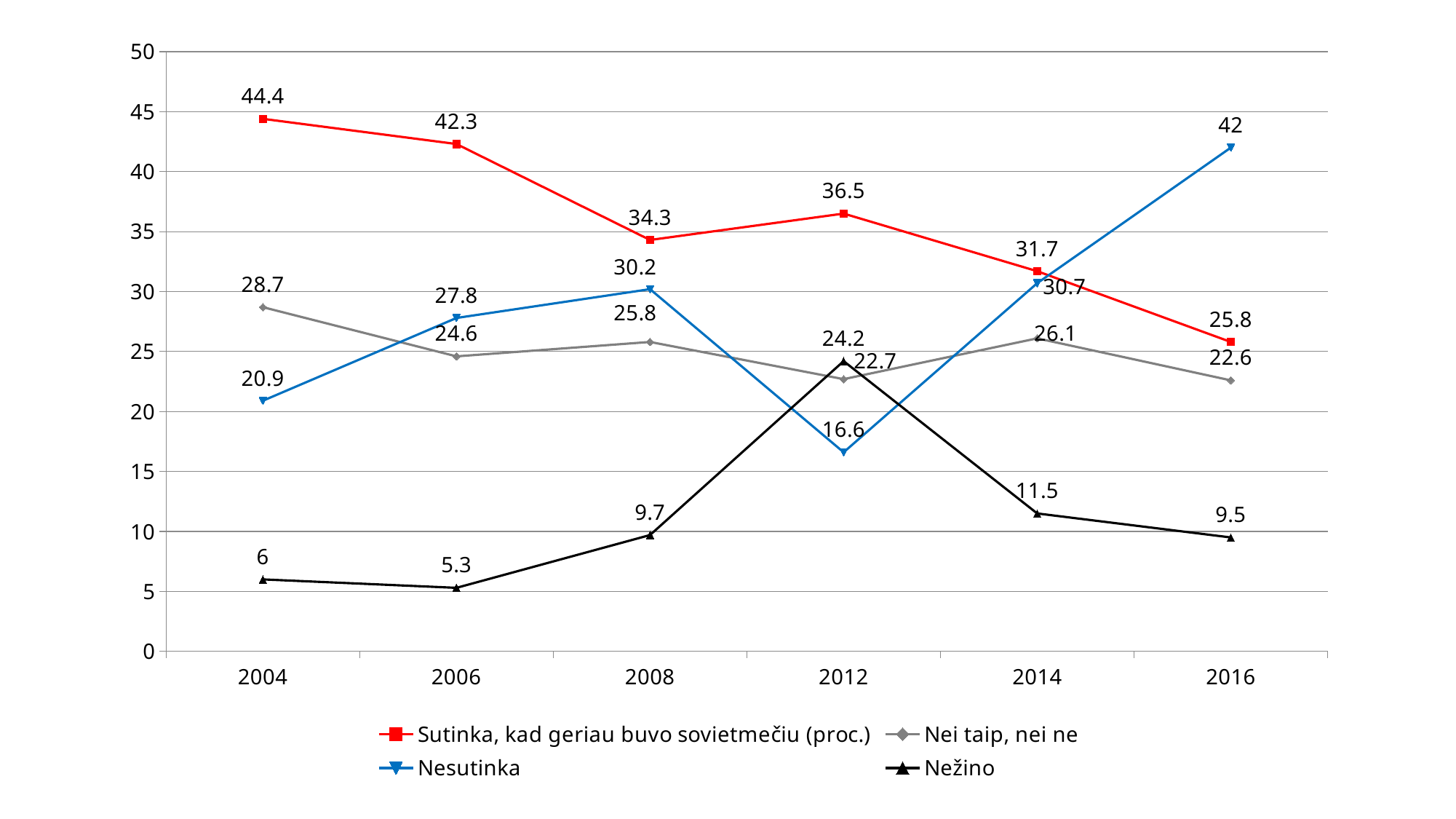
What is the value for 'Sutinka, kad geriau buvo sovietmečiu (proc.)' in 2004? 44.4 What is the value for 'Nesutinka' in 2016? 42 How many series does the legend list? 4 In which year is the 'Nesutinka' series at its lowest? 2012 What type of chart is shown on the slide? line chart What is the value for 'Nei taip, nei ne' in 2014? 26.1 What is the difference between the 'Sutinka, kad geriau buvo sovietmečiu (proc.)' values in 2004 and 2016? 18.6 How many years are shown on the x axis? 6 Which series has the larger value in 2016, 'Nesutinka' or 'Sutinka, kad geriau buvo sovietmečiu (proc.)'? Nesutinka Does the 'Sutinka, kad geriau buvo sovietmečiu (proc.)' series generally rise or fall from 2004 to 2016? fall In which year is the 'Sutinka, kad geriau buvo sovietmečiu (proc.)' series at its highest? 2004 What is the value for 'Nežino' in 2012? 24.2